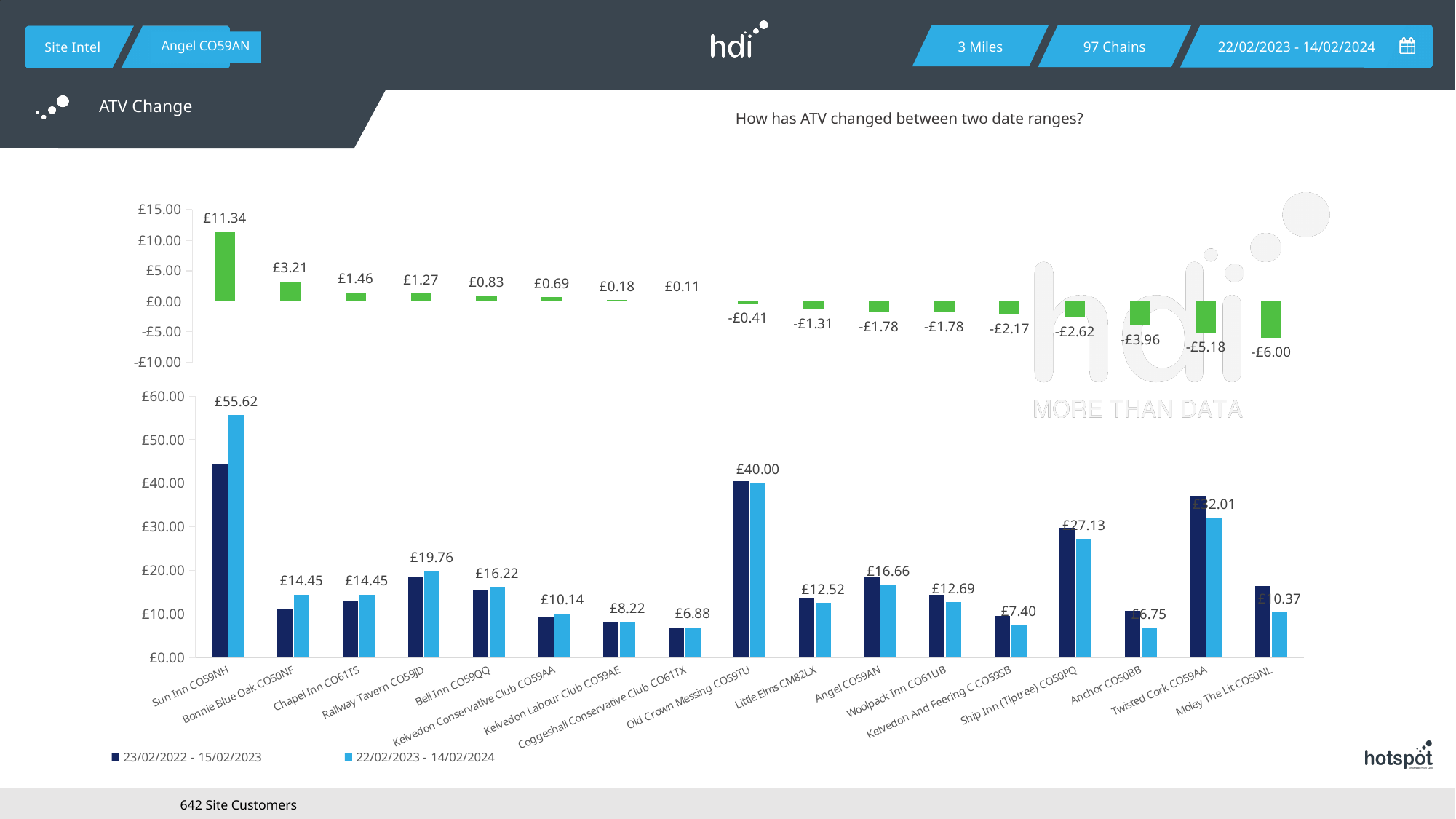
In the top chart, what is the ATV change for Ship Inn (Tiptree) CO50PQ? -£2.62 How many venues are shown on the x axis of the bottom chart? 17 In the bottom chart, what is the value for Old Crown Messing CO59TU in the 22/02/2023 - 14/02/2024 period? £40.00 In the bottom chart, what is the value for Twisted Cork CO59AA in the 22/02/2023 - 14/02/2024 period? £32.01 In the bottom chart, is the value for Sun Inn CO59NH in the 23/02/2022 - 15/02/2023 period greater or less than £40.00? greater In the top chart, which venue has the highest ATV change? Sun Inn CO59NH In the top chart, what is the difference between the ATV change for Sun Inn CO59NH and Bonnie Blue Oak CO50NF? £8.13 In the bottom chart, which is larger for the 22/02/2023 - 14/02/2024 period: Ship Inn (Tiptree) CO50PQ or Twisted Cork CO59AA? Twisted Cork CO59AA How many series does the legend of the bottom chart list? 2 In the top chart, which venue has the lowest ATV change? Moley The Lit CO50NL In the top chart, do the ATV change values rise or fall from left to right? fall In the top chart, what is the ATV change for Sun Inn CO59NH? £11.34